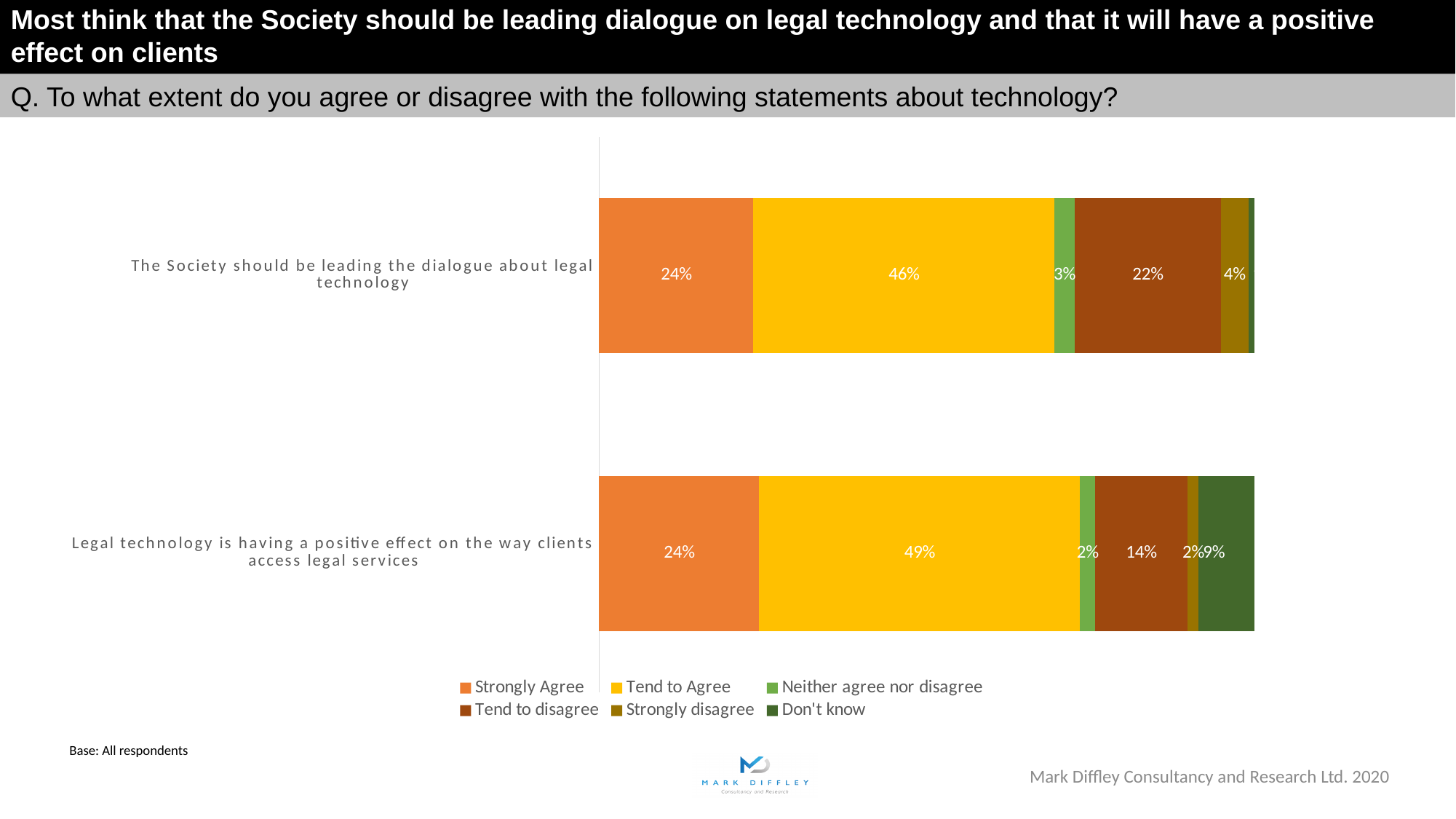
What percentage 'Strongly Agree' that legal technology is having a positive effect on the way clients access legal services? 24% What percentage 'Strongly disagree' that the Society should be leading the dialogue about legal technology? 4% Which statement has the higher 'Tend to Agree' percentage? Legal technology is having a positive effect on the way clients access legal services How many series does the legend list? 6 What percentage of respondents 'Tend to Agree' that the Society should be leading the dialogue about legal technology? 46% What is the difference between the 'Tend to disagree' percentages for the two statements? 8% What is the 'Don't know' percentage for the statement that legal technology is having a positive effect on the way clients access legal services? 9% What percentage 'Tend to disagree' that the Society should be leading the dialogue about legal technology? 22% What colour represents 'Tend to Agree' in the chart? Yellow How many statements (categories) are plotted in the chart? 2 What kind of chart is shown on the slide? Stacked bar chart Which response category is the largest segment for the statement 'The Society should be leading the dialogue about legal technology'? Tend to Agree